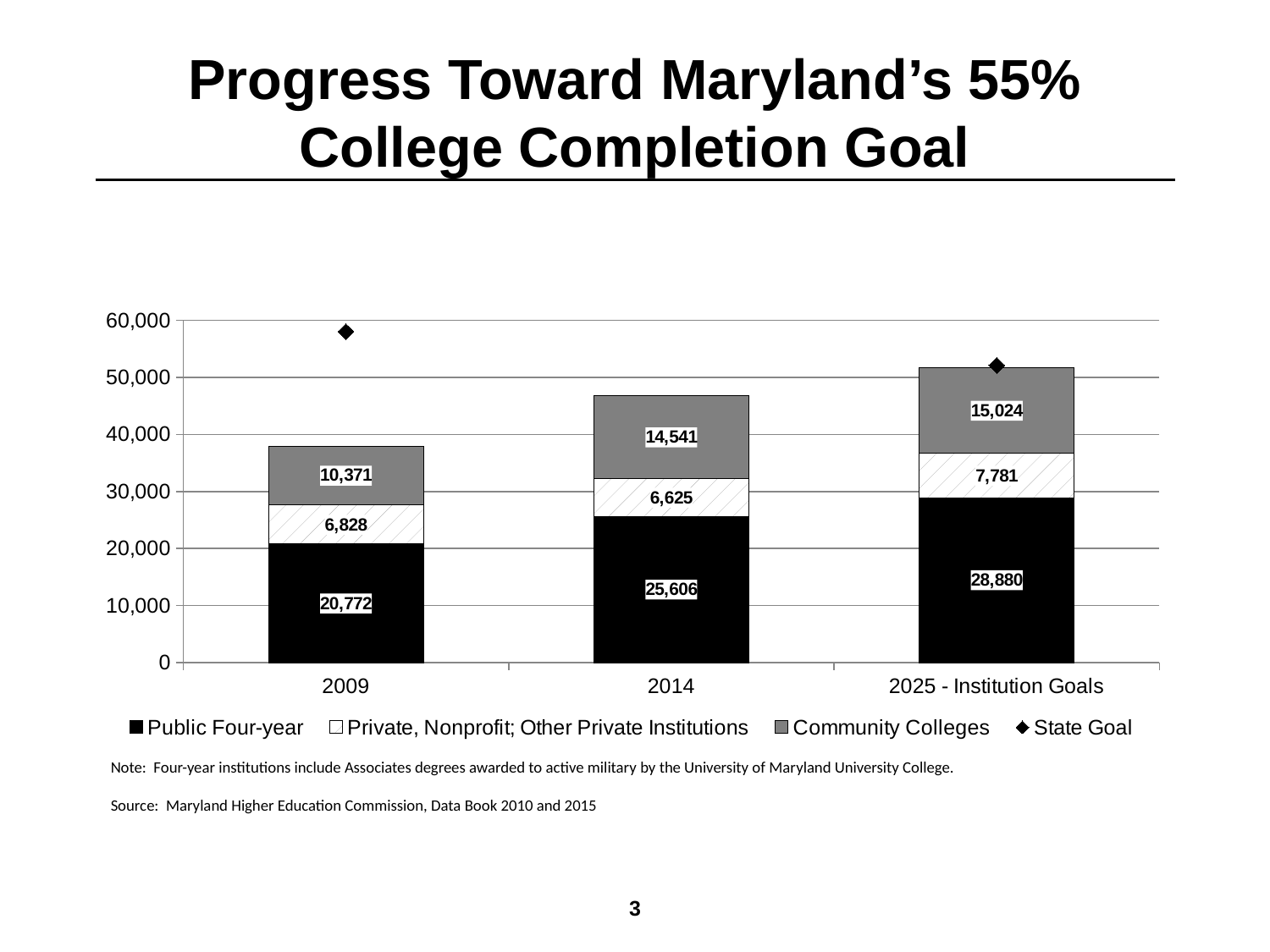
What is the value for Public Four-year in 2014? 25,606 What is the value for Private, Nonprofit; Other Private Institutions in 2009? 6,828 Which year has the lowest value for Public Four-year? 2009 How many categories are shown on the x axis? 3 What is the total of the stacked bar for 2014? 46,772 What kind of chart is shown on the slide? Stacked bar chart How many series does the legend list? 4 Is the State Goal marker for 2009 greater or less than 50,000? greater What is the value for Community Colleges in 2025 - Institution Goals? 15,024 Which is larger: Community Colleges in 2014 or Community Colleges in 2009? Community Colleges in 2014 Which year has the highest value for Community Colleges? 2025 - Institution Goals What is the difference between the Public Four-year values for 2025 - Institution Goals and 2009? 8,108